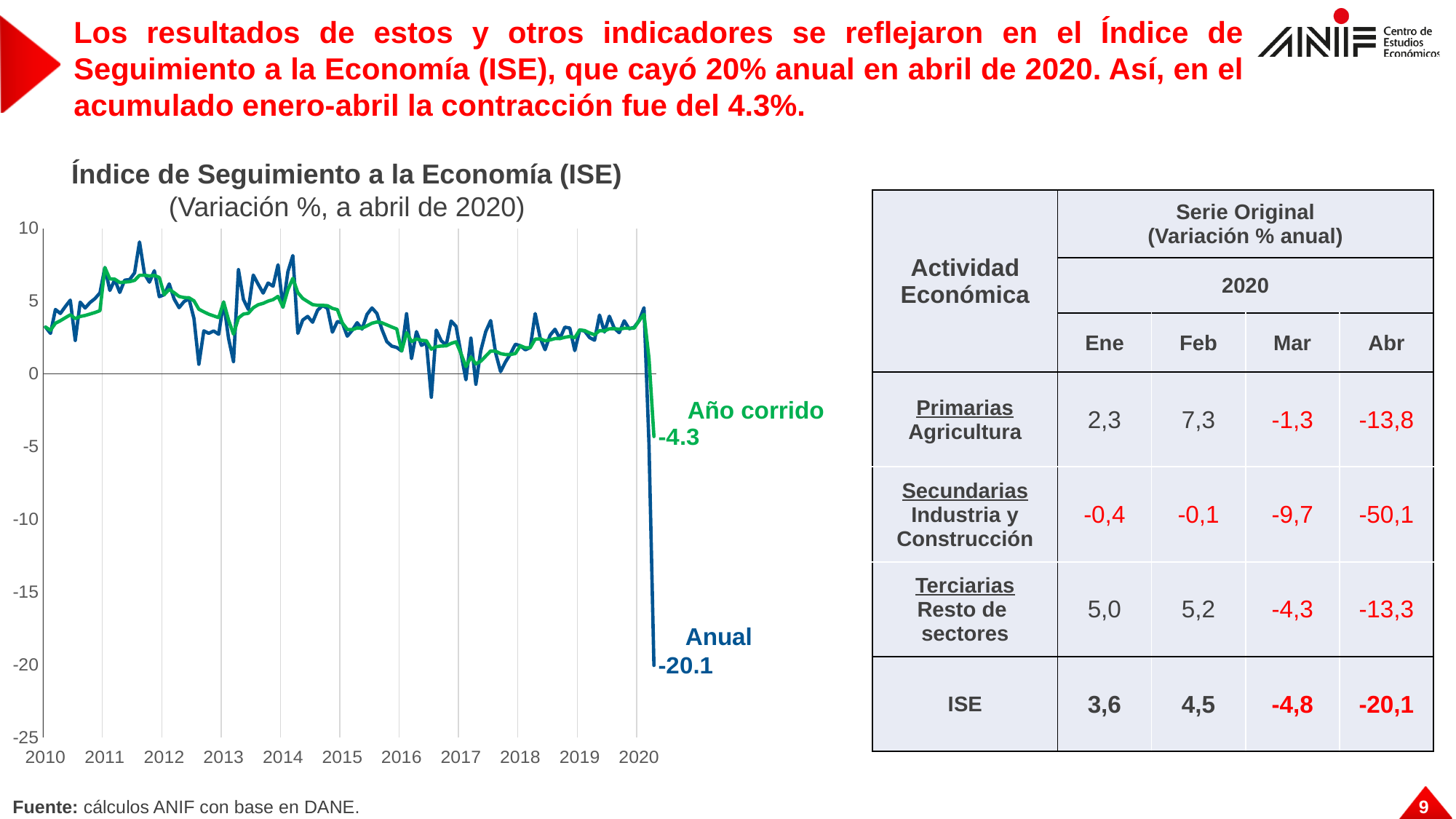
What colour is the line for the Anual series? blue Which series has the lower value at the end of the chart, Anual or Año corrido? Anual What is the title of the chart? Índice de Seguimiento a la Economía (ISE) Is the final value of the Anual series greater or less than -15? less Is the final value of the Año corrido series greater or less than -5? greater How do the values of both series change at the very end of the chart, in 2020? They fall sharply How many year labels are shown on the x axis of the chart? 11 What kind of chart is shown on the slide? line chart What is the difference between the final labelled values of the Año corrido series (-4.3) and the Anual series (-20.1)? 15.8 What is the labelled value of the Año corrido series at the end of the chart (April 2020)? -4.3 What is the labelled value of the Anual series at the end of the chart (April 2020)? -20.1 How many series are plotted in the chart? 2